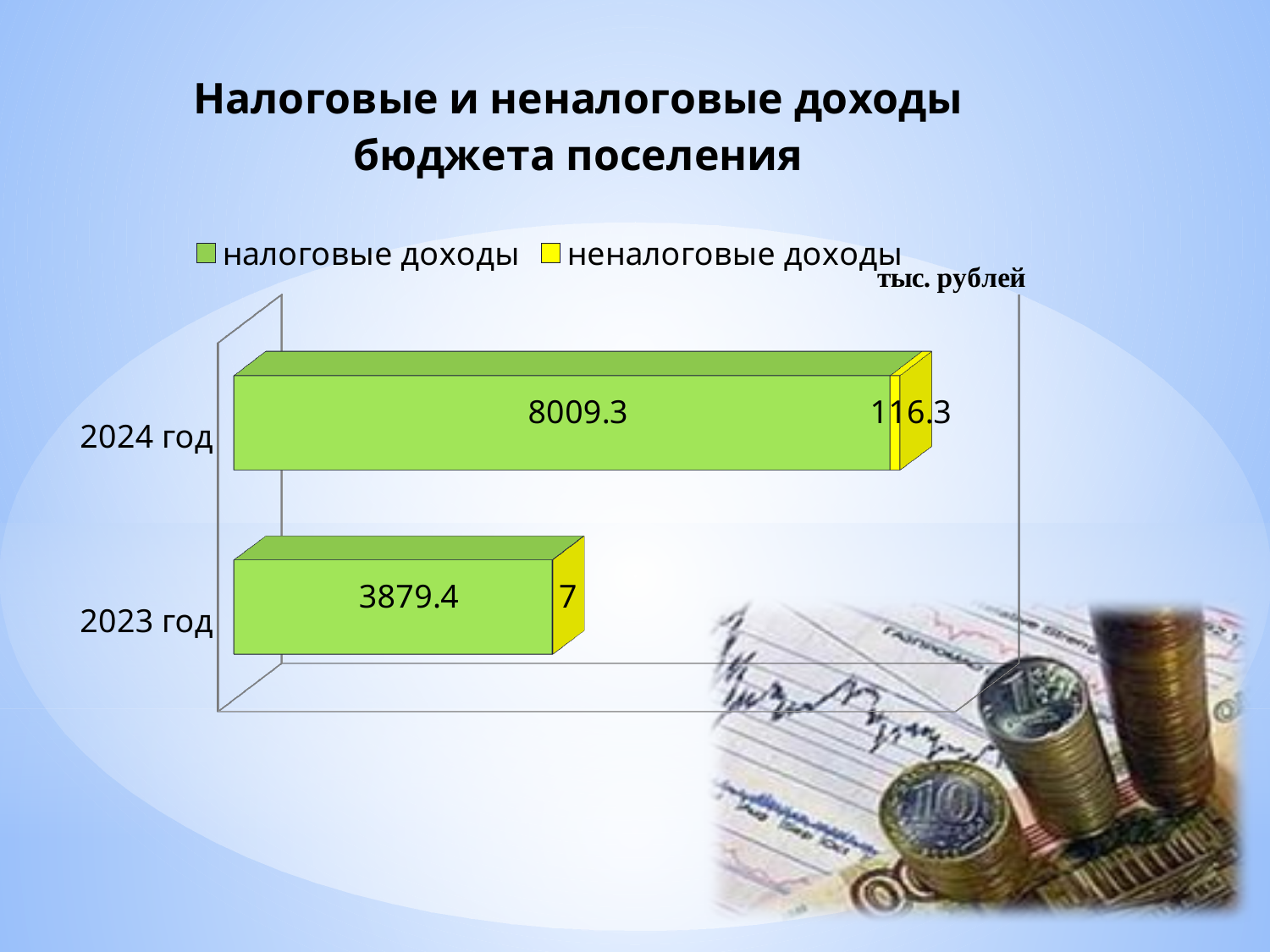
Which year has the lower value of неналоговые доходы? 2023 год What is the total of the stacked bar for 2024 год? 8125.6 Which year has the higher value of налоговые доходы? 2024 год What is the value of налоговые доходы for 2023 год? 3879.4 What kind of chart is shown on the slide? Stacked bar chart What is the value of неналоговые доходы for 2023 год? 7 What is the total of the stacked bar for 2023 год? 3886.4 What is the difference between неналоговые доходы in 2024 год and 2023 год? 109.3 What is the value of неналоговые доходы for 2024 год? 116.3 How many series does the legend list? 2 By how much did налоговые доходы in 2024 год exceed those in 2023 год? 4129.9 What is the value of налоговые доходы for 2024 год? 8009.3